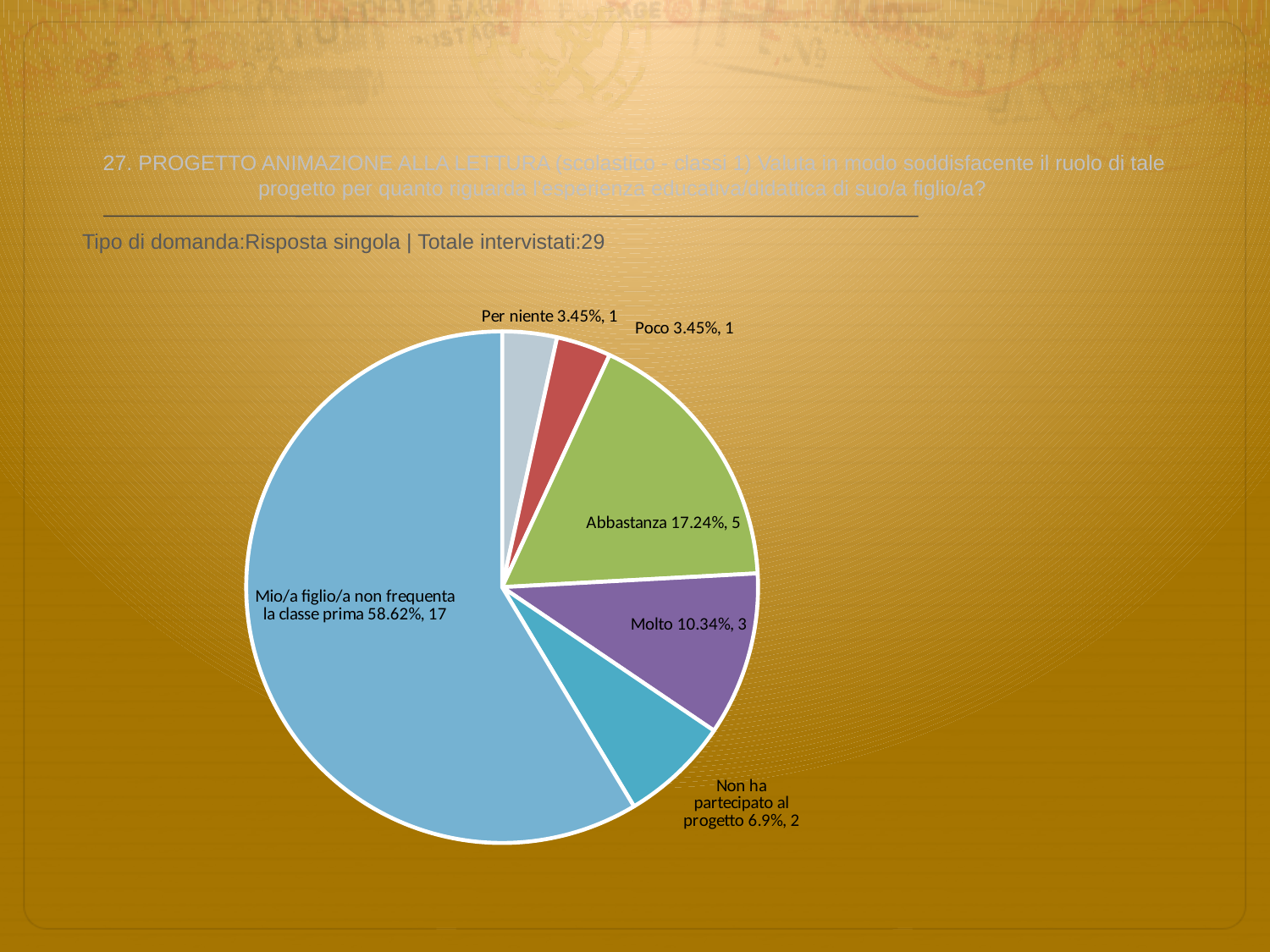
What kind of chart is shown on the slide? pie chart Which category has the largest slice of the pie? Mio/a figlio/a non frequenta la classe prima How many slices does the pie chart have? 6 What is the difference in number of respondents between "Abbastanza" and "Molto"? 2 How many respondents answered "Molto"? 3 What percentage share does the "Per niente" slice have? 3.45% What colour is the "Abbastanza" slice? green Which slice is larger, "Molto" or "Non ha partecipato al progetto"? Molto What is the total number of respondents (Totale intervistati) stated on the slide? 29 What percentage share does the "Non ha partecipato al progetto" slice have? 6.9% What percentage share does the "Abbastanza" slice have? 17.24% How many respondents answered "Mio/a figlio/a non frequenta la classe prima"? 17